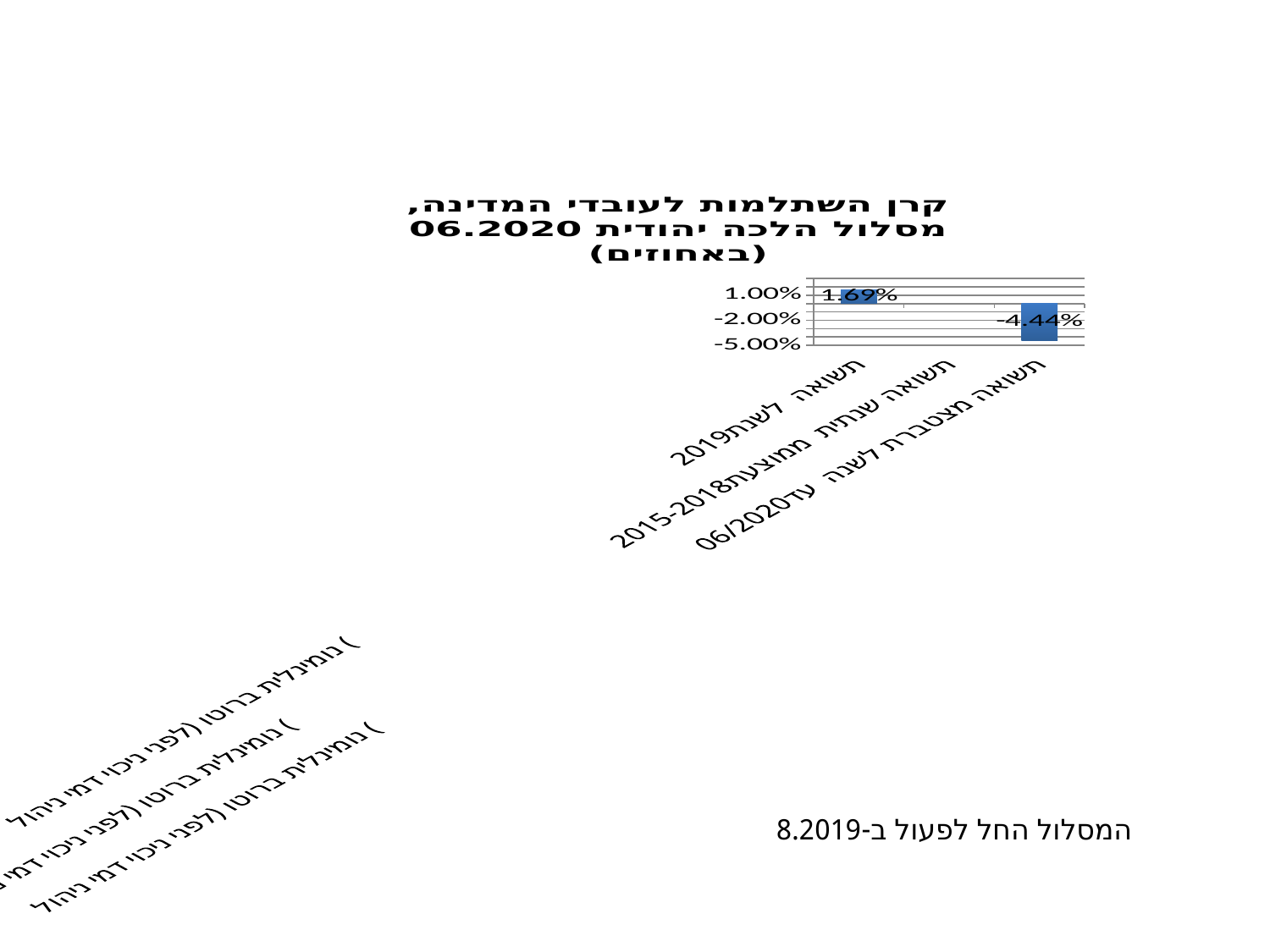
Which is larger: the value for תשואה לשנת 2019 or the value for תשואה מצטברת לשנה עד 06/2020? תשואה לשנת 2019 What kind of chart is shown on the slide? bar chart What is the value shown for תשואה מצטברת לשנה עד 06/2020? -4.44% What is the title of the chart? קרן השתלמות לעובדי המדינה, מסלול הלכה יהודית 06.2020 (באחוזים) Is the value for תשואה לשנת 2019 positive or negative? positive Is the value for תשואה מצטברת לשנה עד 06/2020 greater or less than -2.00%? less Which category has the highest value in the chart? תשואה לשנת 2019 What is the value shown for תשואה לשנת 2019? 1.69% How many categories are shown on the x axis of the chart? 3 What is the difference between the value for תשואה לשנת 2019 and the value for תשואה מצטברת לשנה עד 06/2020? 6.13 percentage points According to the note on the slide, when did the track start operating? 8.2019 Which category has the lowest value in the chart? תשואה מצטברת לשנה עד 06/2020